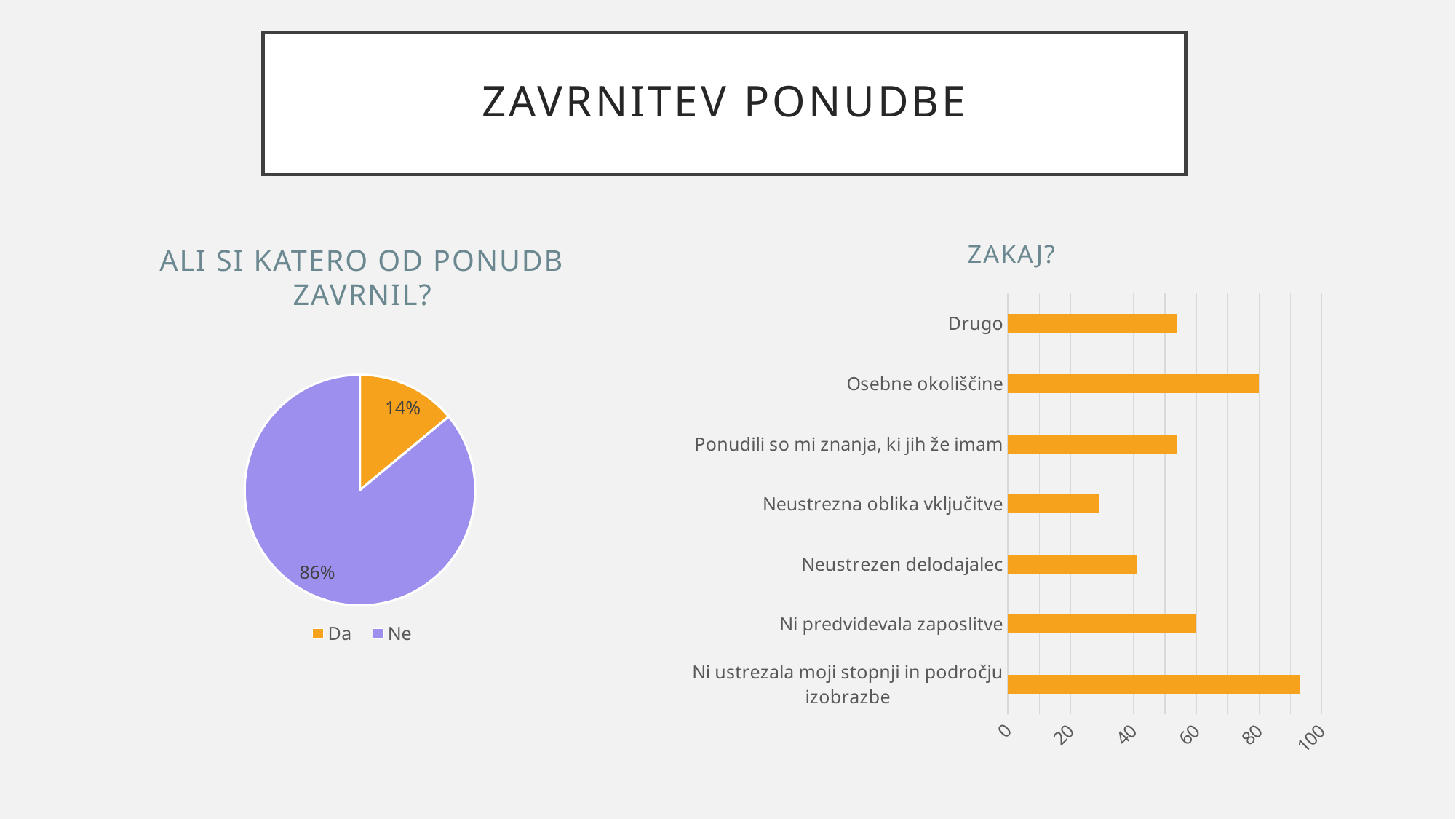
In the bar chart "ZAKAJ?", which category has the lowest value? Neustrezna oblika vključitve How many entries does the legend of the pie chart "ALI SI KATERO OD PONUDB ZAVRNIL?" list? 2 What type of chart is the left chart titled "ALI SI KATERO OD PONUDB ZAVRNIL?"? Pie chart What type of chart is the right chart titled "ZAKAJ?"? Bar chart In the pie chart "ALI SI KATERO OD PONUDB ZAVRNIL?", what share of respondents answered "Da"? 14% In the pie chart "ALI SI KATERO OD PONUDB ZAVRNIL?", which answer has the larger share? Ne How many categories are shown in the bar chart "ZAKAJ?"? 7 In the pie chart "ALI SI KATERO OD PONUDB ZAVRNIL?", what share of respondents answered "Ne"? 86% In the bar chart "ZAKAJ?", is the value for "Osebne okoliščine" greater or less than 60? greater In the bar chart "ZAKAJ?", which category has the highest value? Ni ustrezala moji stopnji in področju izobrazbe In the pie chart "ALI SI KATERO OD PONUDB ZAVRNIL?", how many percentage points larger is the "Ne" share than the "Da" share? 72 percentage points In the bar chart "ZAKAJ?", which is larger: the value for "Osebne okoliščine" or the value for "Neustrezen delodajalec"? Osebne okoliščine